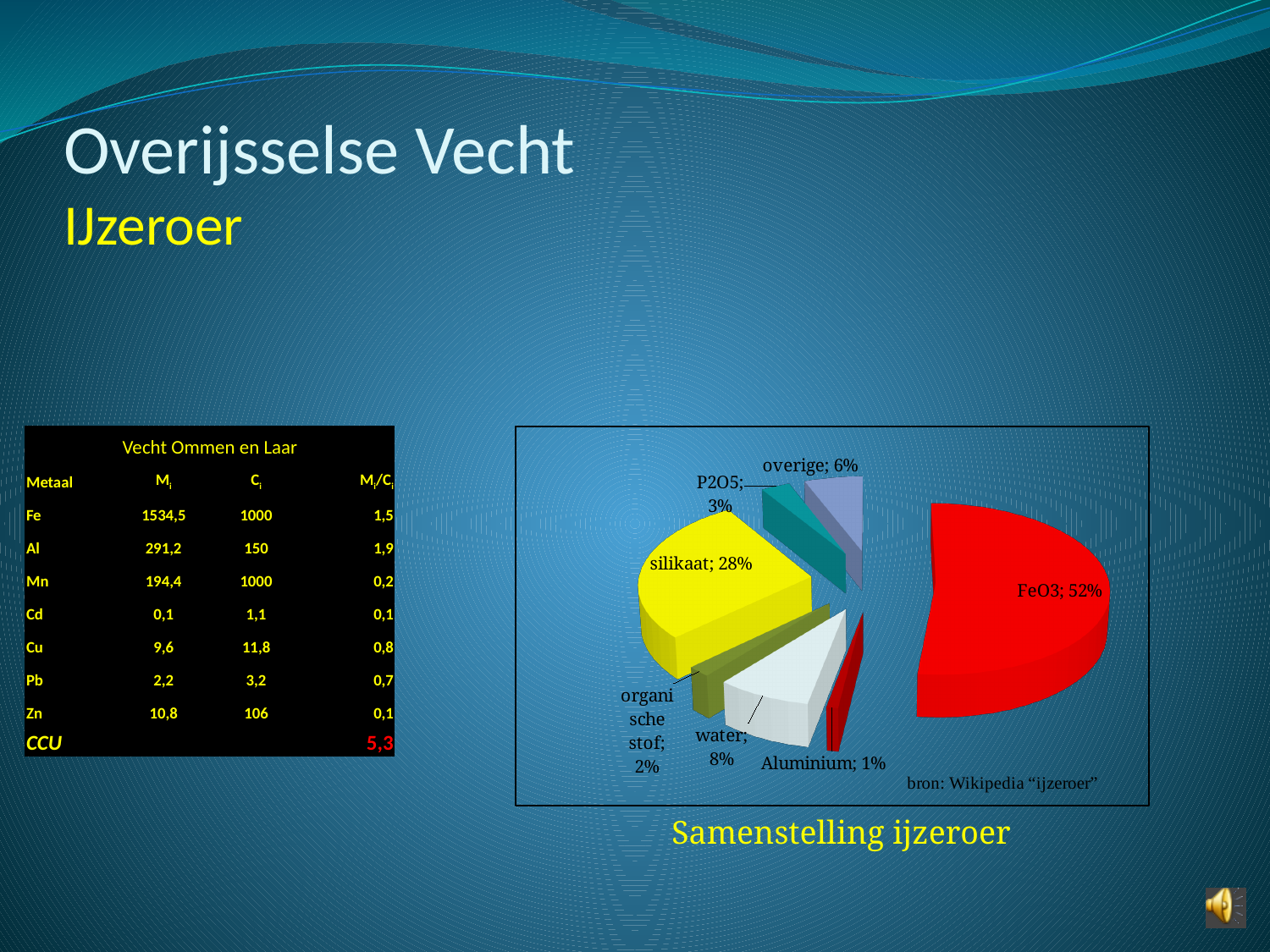
What is the title shown below the pie chart? Samenstelling ijzeroer What share of the pie does FeO3 have? 52% What percentage is shown for water in the pie chart? 8% What percentage is shown for overige in the pie chart? 6% What is the difference in percentage points between FeO3 and silikaat? 24 What share of the pie does silikaat have? 28% What percentage is shown for Aluminium in the pie chart? 1% What percentage is shown for P2O5 in the pie chart? 3% How many slices does the pie chart have? 7 What kind of chart is shown on the slide? pie chart Which slice of the pie chart is the smallest? Aluminium Which slice of the pie chart is the largest? FeO3